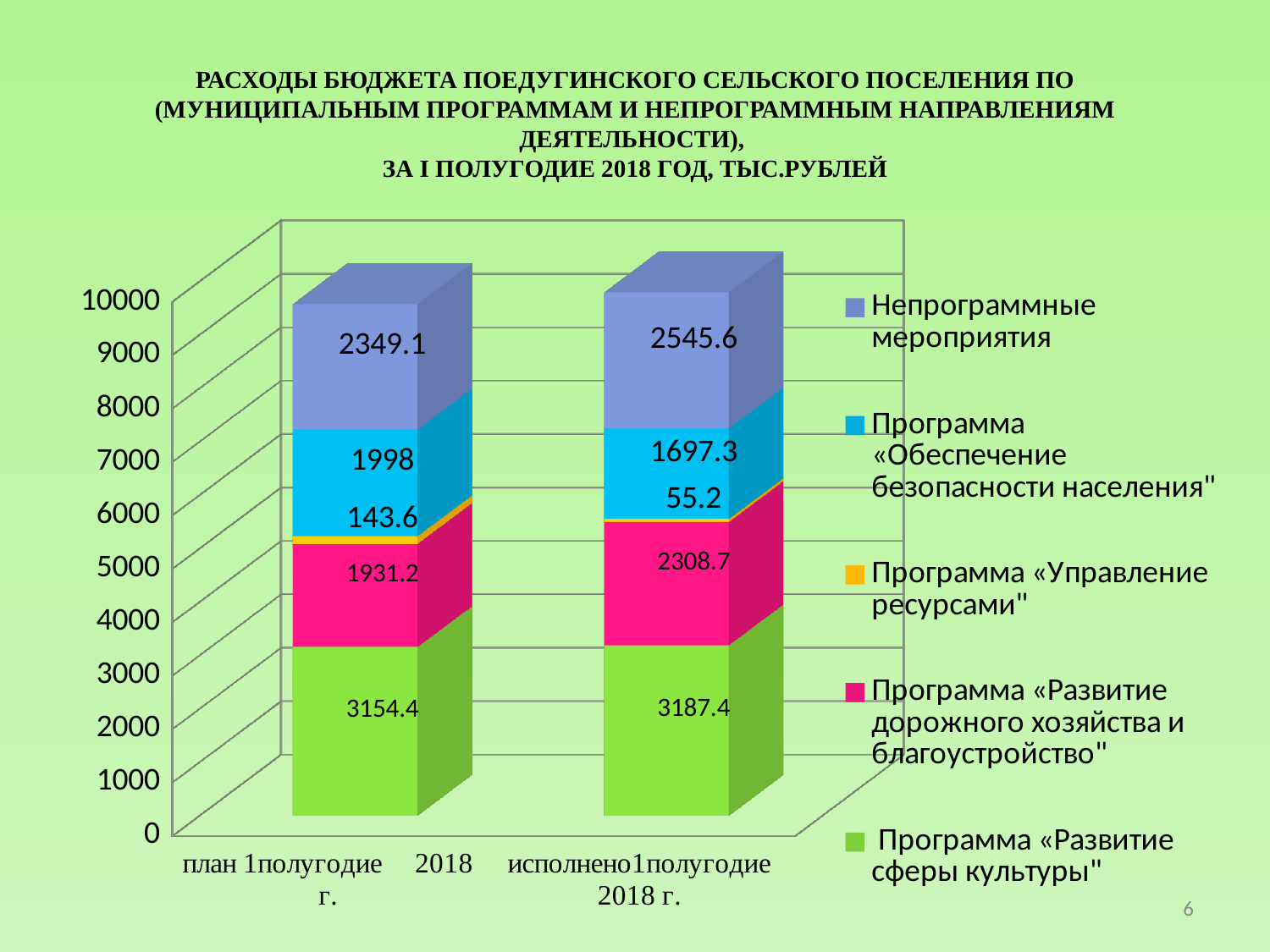
What is the total of the «план 1полугодие 2018 г.» stacked bar? 9576.3 What is the total of the «исполнено 1полугодие 2018 г.» stacked bar? 9794.2 Which series has the largest value in the «исполнено 1полугодие 2018 г.» bar? Программа «Развитие сферы культуры» What is the value of Программа «Обеспечение безопасности населения» for «исполнено 1полугодие 2018 г.»? 1697.3 Which series has the smallest value in the «план 1полугодие 2018 г.» bar? Программа «Управление ресурсами» What kind of chart is shown on the slide? Stacked bar chart Which is larger for Программа «Обеспечение безопасности населения»: the «план» value or the «исполнено» value? план (1998) What is the value of Программа «Управление ресурсами» for «план 1полугодие 2018 г.»? 143.6 What is the value of «Непрограммные мероприятия» for «план 1полугодие 2018 г.»? 2349.1 What is the value of Программа «Развитие дорожного хозяйства и благоустройство» for «исполнено 1полугодие 2018 г.»? 2308.7 What is the difference between the «исполнено» and «план» values for «Непрограммные мероприятия»? 196.5 How many series does the legend list? 5